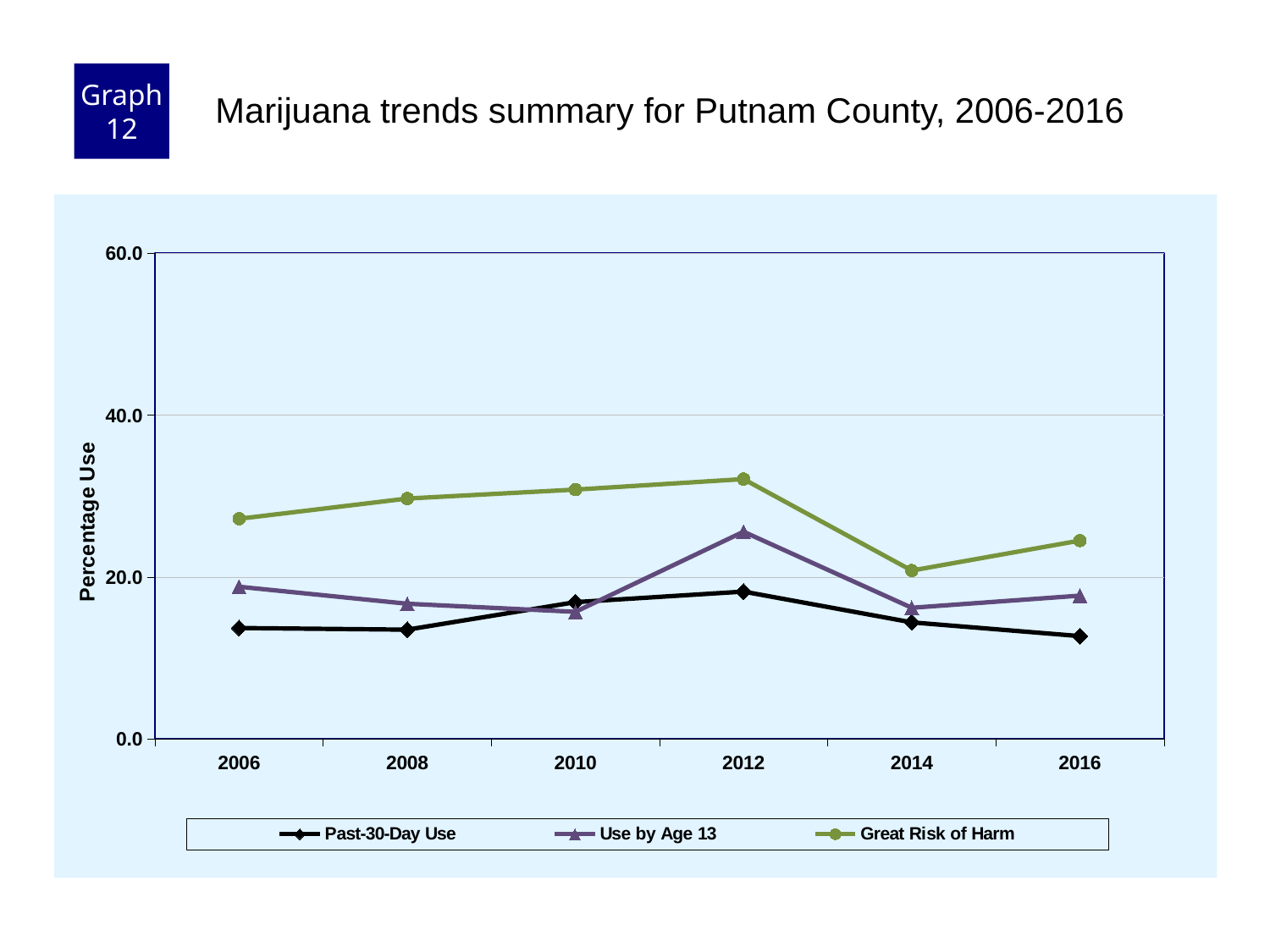
In which year is the Use by Age 13 series at its highest? 2012 Does the Great Risk of Harm series rise or fall from 2006 to 2012? rise Which series has the highest value in 2012? Great Risk of Harm Is the value for Great Risk of Harm in 2008 greater or less than 40.0? less How many series does the legend list? 3 Is the value for Great Risk of Harm in 2012 greater or less than 20.0? greater What kind of chart is shown on the slide? line chart What is the label on the y axis? Percentage Use In 2012, which is larger: Use by Age 13 or Past-30-Day Use? Use by Age 13 In which year is the Great Risk of Harm series at its lowest? 2014 How many years are plotted along the x axis? 6 Is the value for Past-30-Day Use in 2016 greater or less than 20.0? less